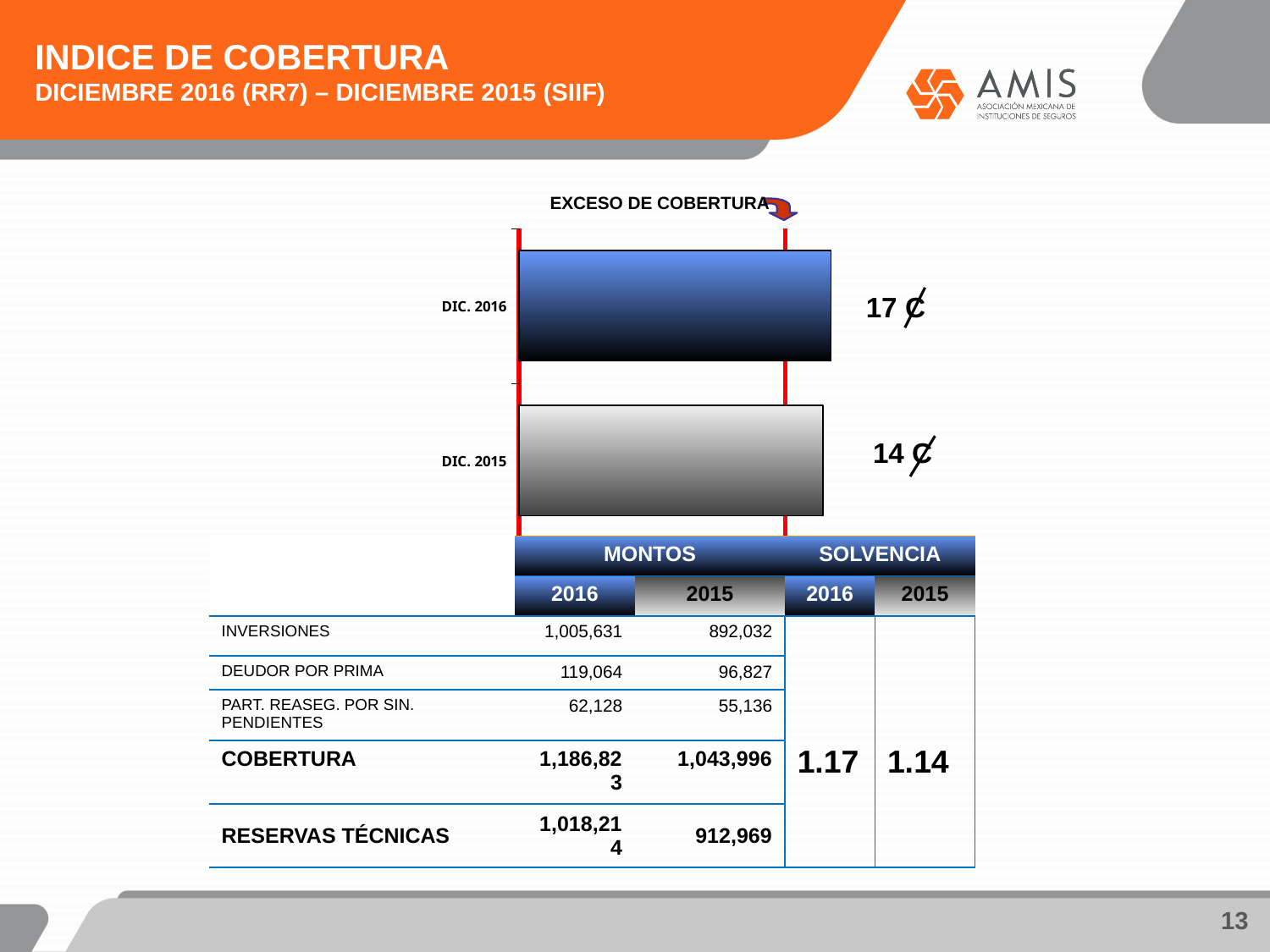
What value is labelled next to the DIC. 2015 bar? 14 ¢ What kind of chart is shown on the slide? bar chart What colour is the DIC. 2016 bar? blue What value is labelled next to the DIC. 2016 bar? 17 ¢ How many bars does the chart show? 2 Is the value for DIC. 2016 larger or smaller than the value for DIC. 2015? larger What is the title shown above the chart? EXCESO DE COBERTURA What is the difference between the DIC. 2016 and DIC. 2015 values labelled on the chart? 3 ¢ Which period has the shorter bar in the chart? DIC. 2015 Which period has the longer bar in the chart? DIC. 2016